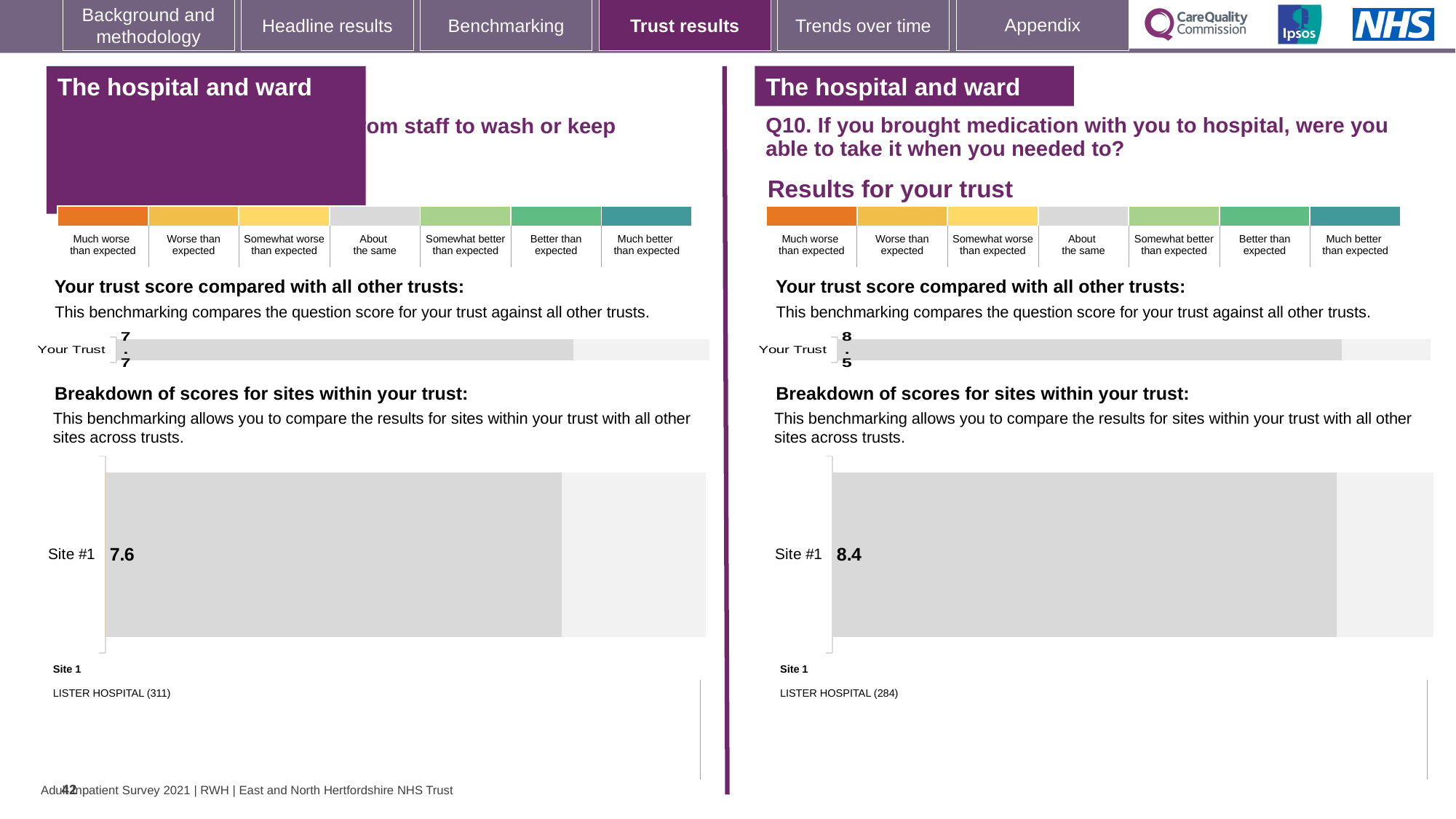
On the left-hand panel, what is the difference between the Your Trust score and the Site #1 score? 0.1 On the right-hand panel (Q10, medication), what is the score shown for Your Trust in the 'Your trust score compared with all other trusts' chart? 8.5 On the left-hand panel, what score is shown for Site #1 in the breakdown of scores for sites chart? 7.6 On the right-hand panel (Q10), which is larger: the Your Trust score or the Site #1 score? Your Trust On the right-hand panel (Q10), what is the difference between the Your Trust score and the Site #1 score? 0.1 What type of chart is used to show the Site #1 score on the right-hand panel (Q10)? Bar chart How many sites are shown in the breakdown of scores chart on the right-hand panel (Q10)? 1 On the left-hand panel, which is larger: the Your Trust score or the Site #1 score? Your Trust On the right-hand panel (Q10, medication), what score is shown for Site #1 in the breakdown of scores for sites chart? 8.4 Which panel shows the higher Site #1 score, the left-hand panel or the right-hand panel (Q10)? Right-hand panel (Q10) On the left-hand panel, what is the score shown for Your Trust in the 'Your trust score compared with all other trusts' chart? 7.7 On the right-hand panel (Q10), which hospital is listed as Site 1 below the breakdown chart? LISTER HOSPITAL (284)